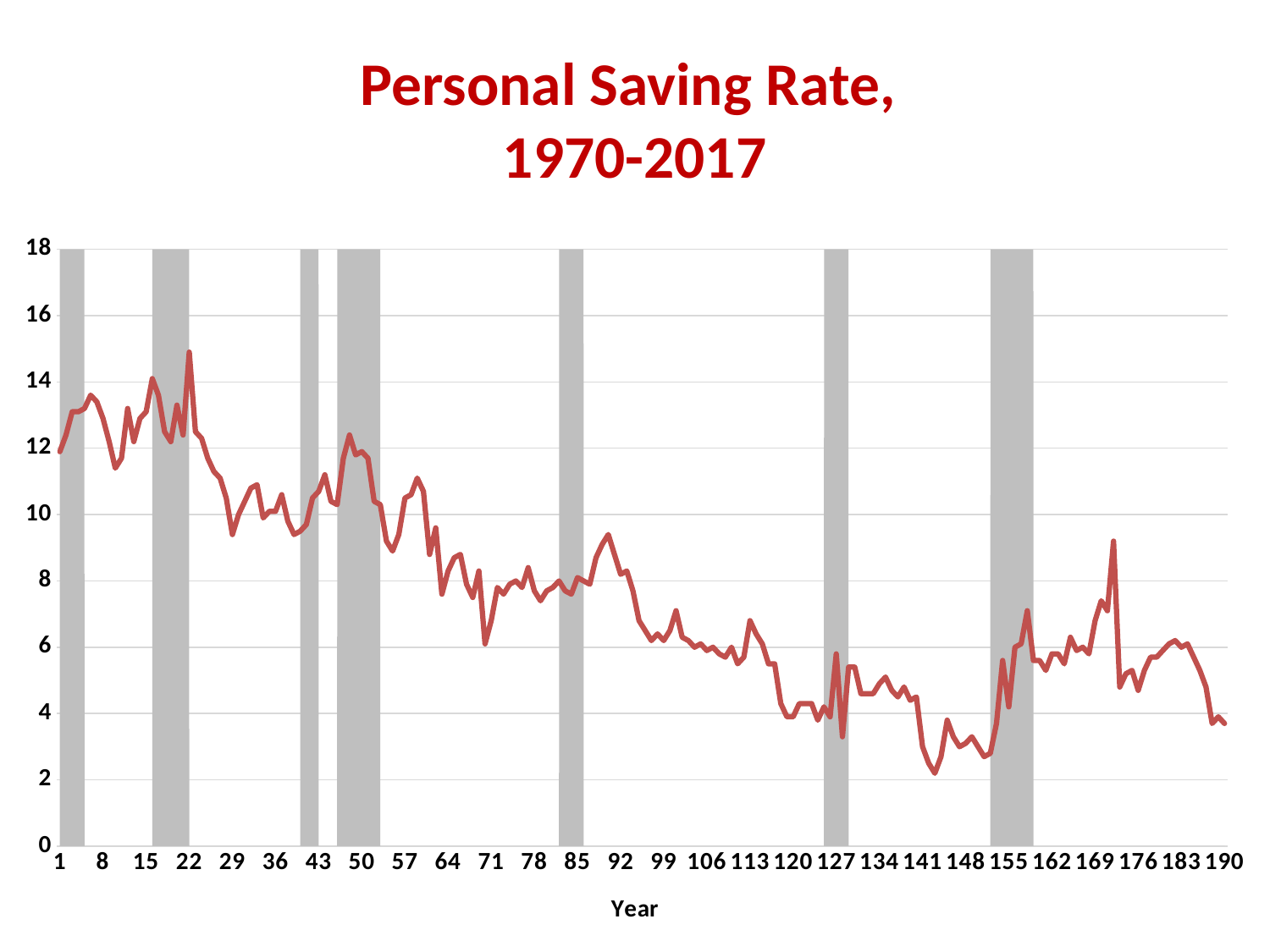
Is the value of the line at x = 190 greater or less than 6? less What is the title of the chart? Personal Saving Rate, 1970-2017 Is the value of the line at x = 50 greater or less than 10? greater What kind of chart is shown on the slide? line chart Is the value of the line at x = 71 greater or less than 8? less Between which two x-axis ticks does the line reach its lowest point? 141 and 148 Overall, does the personal saving rate rise or fall from left to right along the x axis? fall Near which x-axis tick does the line reach its highest point? 22 What is the label on the x axis of the chart? Year Which is larger, the value of the line at x = 8 or at x = 120? x = 8